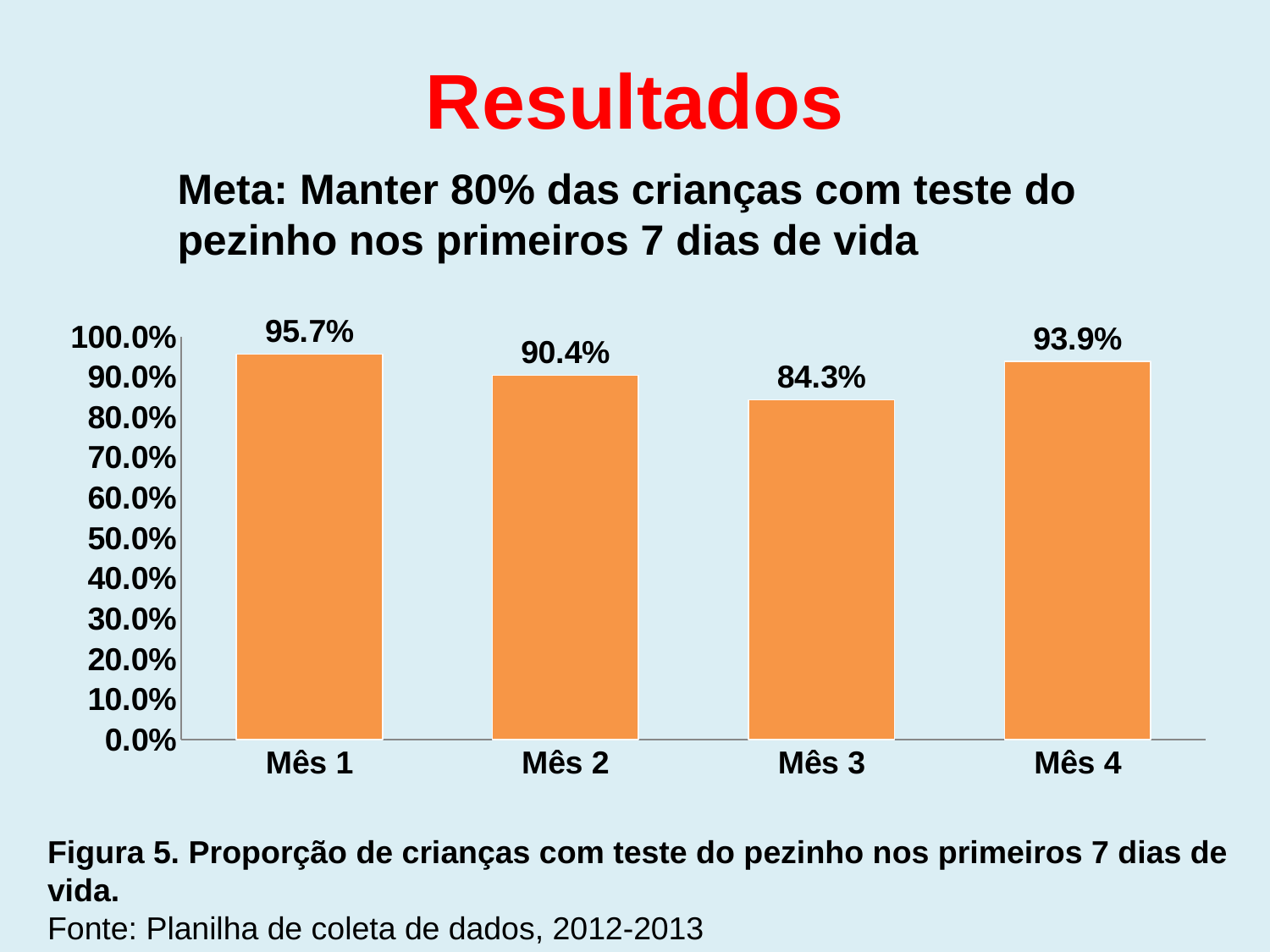
What is the difference between the values for Mês 1 and Mês 3? 11.4% What is the value for Mês 1? 95.7% Is the value for Mês 3 greater or less than 80.0%? greater Which is larger, the value for Mês 2 or the value for Mês 4? Mês 4 Which month has the highest value? Mês 1 What is the difference between the values for Mês 4 and Mês 2? 3.5% What is the value for Mês 4? 93.9% Which month has the lowest value? Mês 3 What is the figure caption below the chart? Figura 5. Proporção de crianças com teste do pezinho nos primeiros 7 dias de vida. What kind of chart is shown on the slide? bar chart What is the value for Mês 3? 84.3% How many months are shown on the x axis? 4